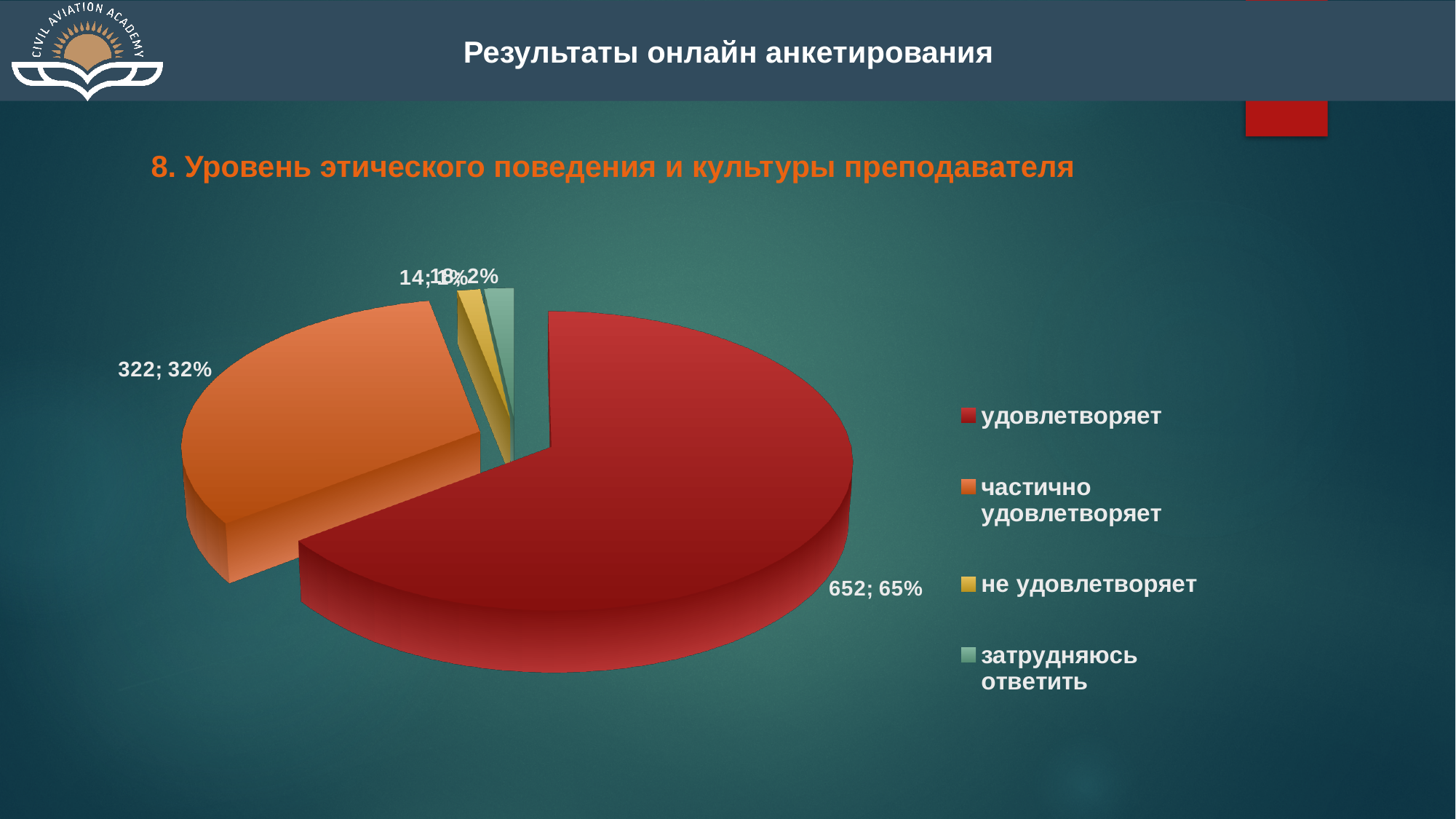
What is the value shown for the 'частично удовлетворяет' slice? 322; 32% What share of the pie does the 'частично удовлетворяет' slice represent? 32% Which is larger: 'удовлетворяет' or 'частично удовлетворяет'? удовлетворяет Which colour represents 'частично удовлетворяет' in the legend? orange What kind of chart is shown on the slide? pie chart What share of the pie does the 'удовлетворяет' slice represent? 65% What is the title of the chart on the slide? 8. Уровень этического поведения и культуры преподавателя What is the difference in count between 'удовлетворяет' (652) and 'частично удовлетворяет' (322)? 330 How many categories does the pie chart have? 4 Which category has the largest slice of the pie? удовлетворяет What is the value shown for the 'удовлетворяет' slice? 652; 65%